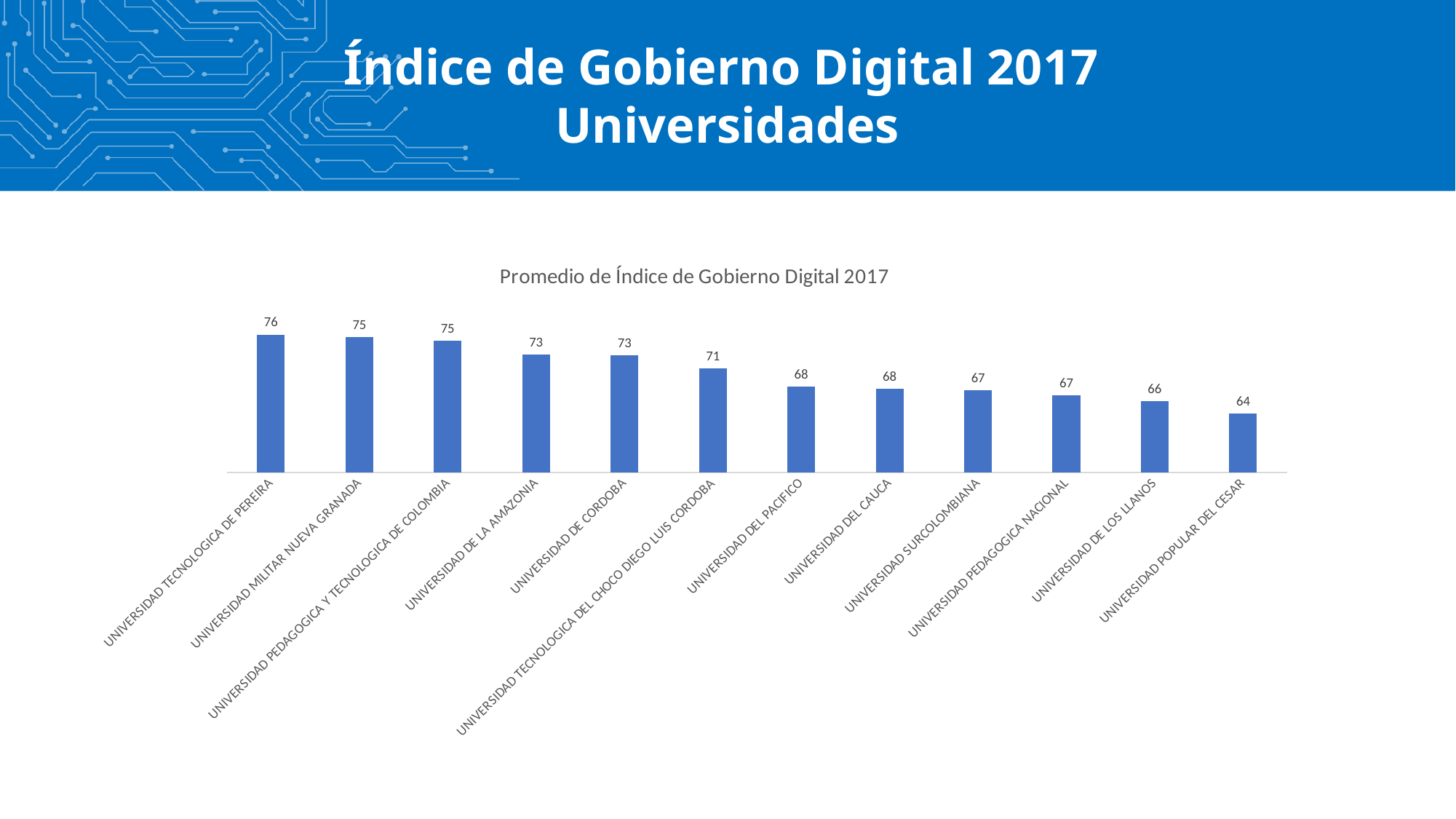
What is the value for UNIVERSIDAD DEL PACIFICO? 68 Which university has the highest value? UNIVERSIDAD TECNOLOGICA DE PEREIRA What is the value for UNIVERSIDAD DE LA AMAZONIA? 73 What is the difference between the values for UNIVERSIDAD TECNOLOGICA DE PEREIRA and UNIVERSIDAD POPULAR DEL CESAR? 12 What is the value for UNIVERSIDAD DE LOS LLANOS? 66 Which is larger, the value for UNIVERSIDAD TECNOLOGICA DEL CHOCO DIEGO LUIS CORDOBA or the value for UNIVERSIDAD SURCOLOMBIANA? UNIVERSIDAD TECNOLOGICA DEL CHOCO DIEGO LUIS CORDOBA What is the difference between the values for UNIVERSIDAD DE CORDOBA and UNIVERSIDAD DEL CAUCA? 5 How many universities are shown in the chart? 12 What is the value for UNIVERSIDAD TECNOLOGICA DE PEREIRA? 76 Which university has the lowest value? UNIVERSIDAD POPULAR DEL CESAR What is the title of the chart? Promedio de Índice de Gobierno Digital 2017 What kind of chart is shown on the slide? Bar chart